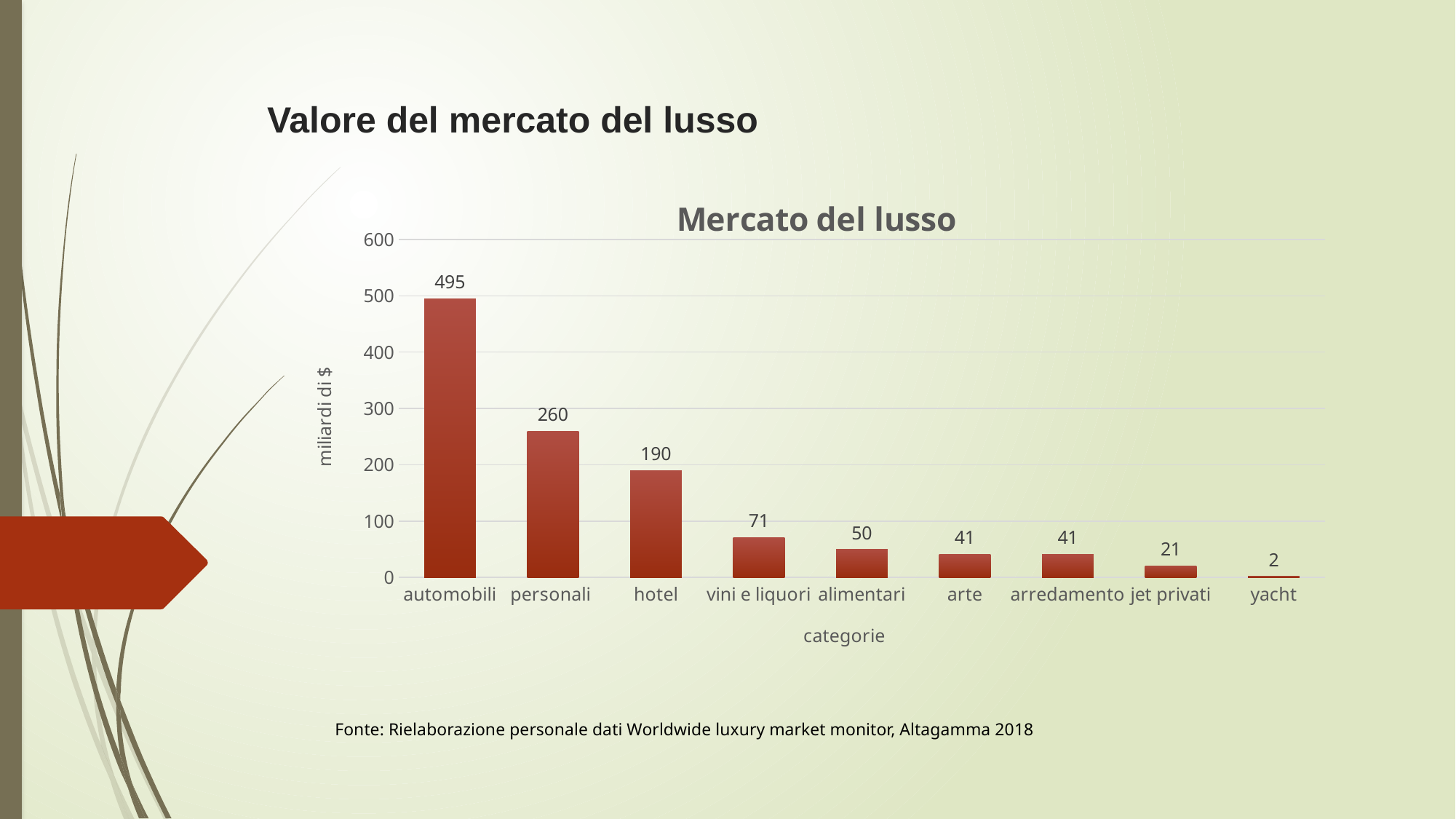
How many categories are shown on the x axis? 9 Is the value for personali greater or less than 300? less What is the value for automobili? 495 What kind of chart is shown? bar chart Which category has the highest value? automobili What is the value for hotel? 190 Which category has the lowest value? yacht What is the difference between the values for automobili and personali? 235 What is the value for jet privati? 21 What is the difference between the values for vini e liquori and alimentari? 21 Which is larger, the value for hotel or the value for personali? personali What is the title of the chart? Mercato del lusso